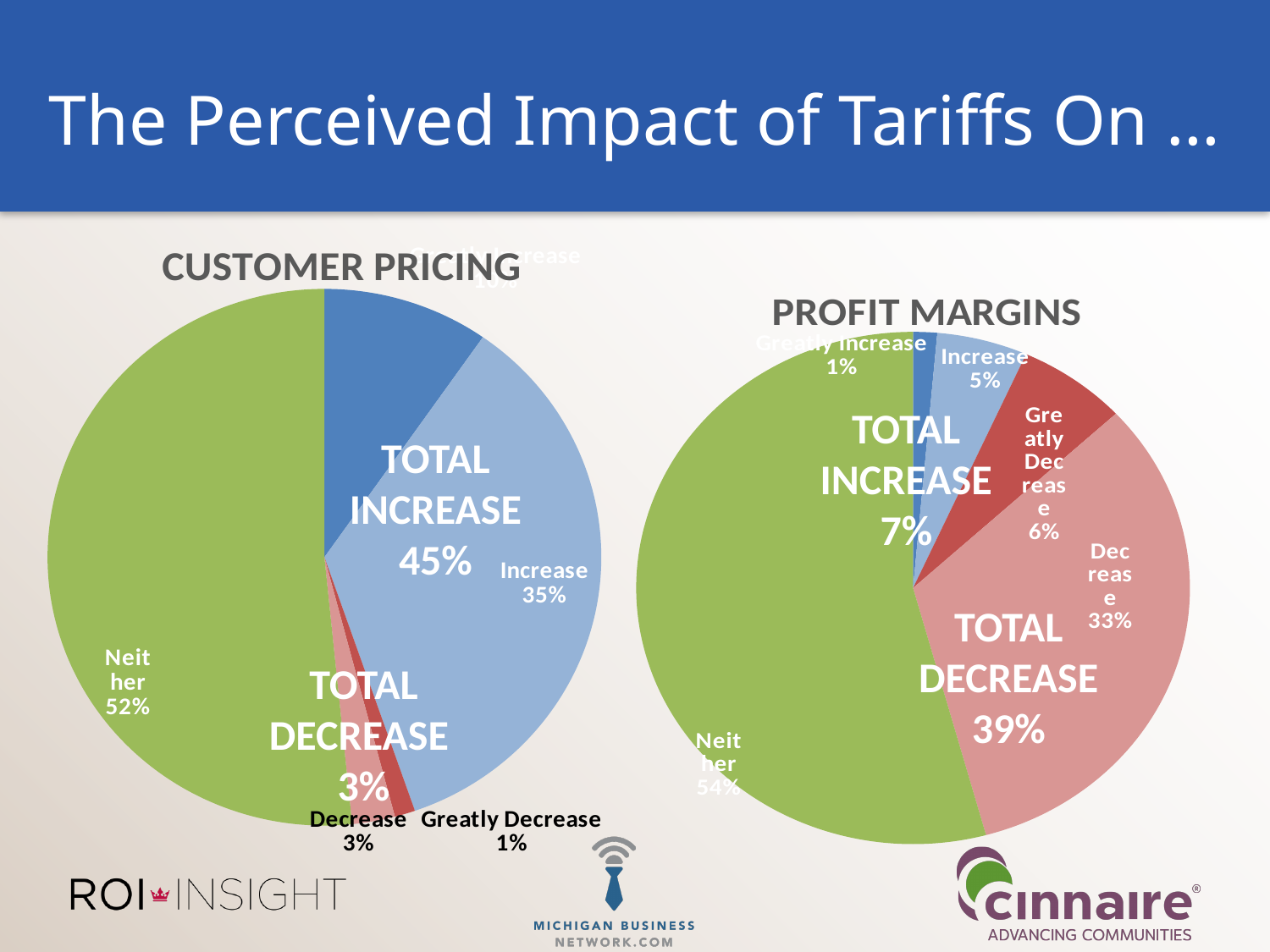
In the Customer Pricing chart, what is the share for Greatly Decrease? 1% In the Profit Margins chart, which slice is the largest? Neither In the Customer Pricing chart, what percentage of respondents said Increase? 35% Which chart shows a larger share for Neither, Customer Pricing or Profit Margins? Profit Margins In the Profit Margins chart, what is the share for Greatly Increase? 1% What type of chart is used for Profit Margins? Pie chart In the Customer Pricing chart, which slice is the largest? Neither In the Profit Margins chart, what is the difference between the Decrease and Greatly Decrease shares? 27 percentage points In the Customer Pricing chart, what is the share for Neither? 52% In the Customer Pricing chart, what is the Total Increase percentage? 45% In the Profit Margins chart, what is the Total Decrease percentage? 39% In the Profit Margins chart, what percentage is labeled Decrease? 33%